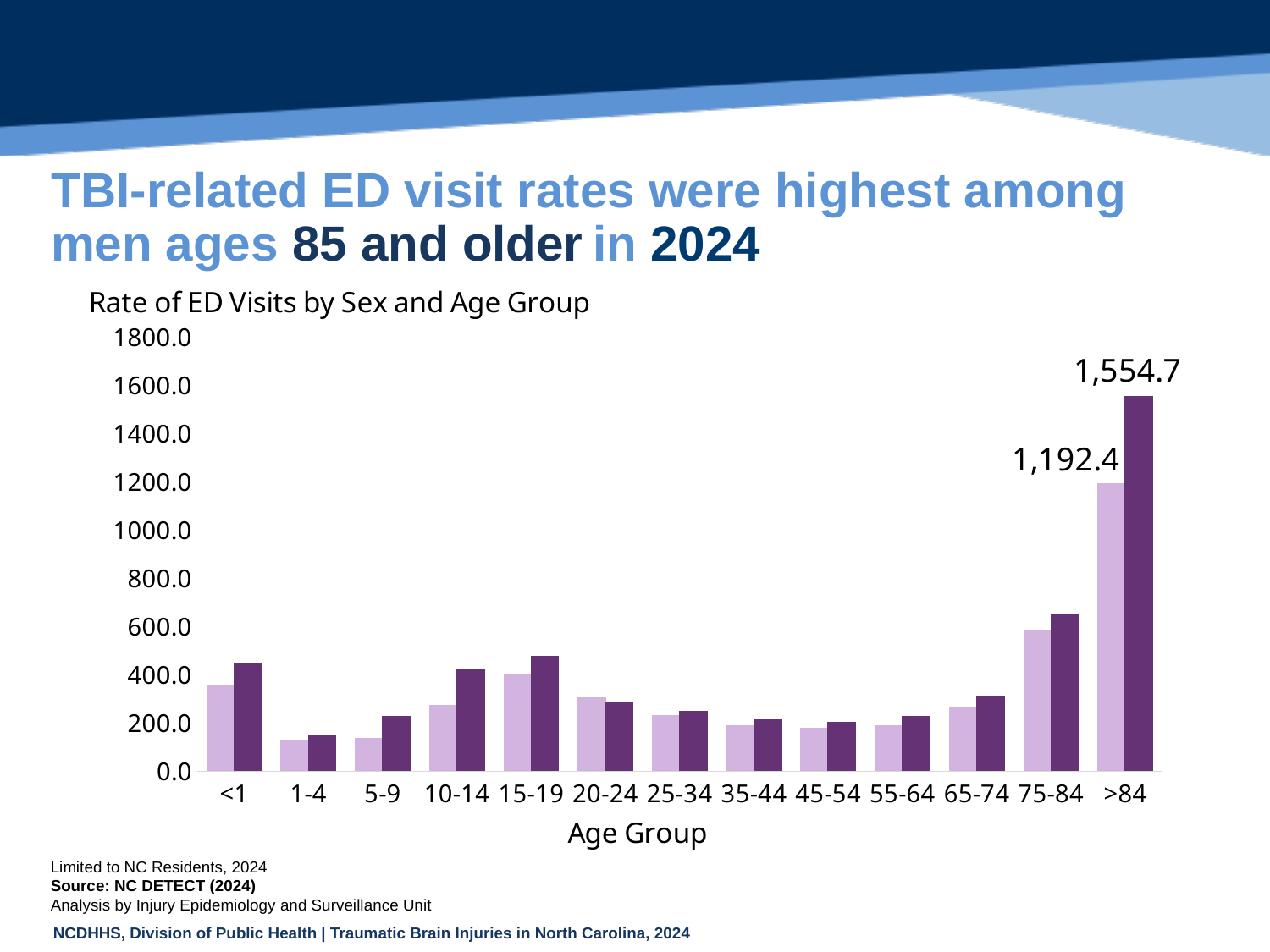
What kind of chart is shown on the slide? bar chart Is the value of the lighter bar for the 1-4 age group greater or less than 200? less Which is larger: the darker bar for <1 or the darker bar for 1-4? <1 What is the highest value labeled on the chart? 1,554.7 Is the value of the darker bar for the 15-19 age group greater or less than 400? greater What is the difference between the two labeled values for the >84 age group? 362.3 Which age group has the highest ED visit rate? >84 What is the value of the lighter bar for the >84 age group? 1,192.4 What is the title of the chart? Rate of ED Visits by Sex and Age Group What is the value of the darker bar for the >84 age group? 1,554.7 From the 45-54 age group to the >84 age group, do the darker bars rise or fall? rise How many age groups are shown on the x axis? 13